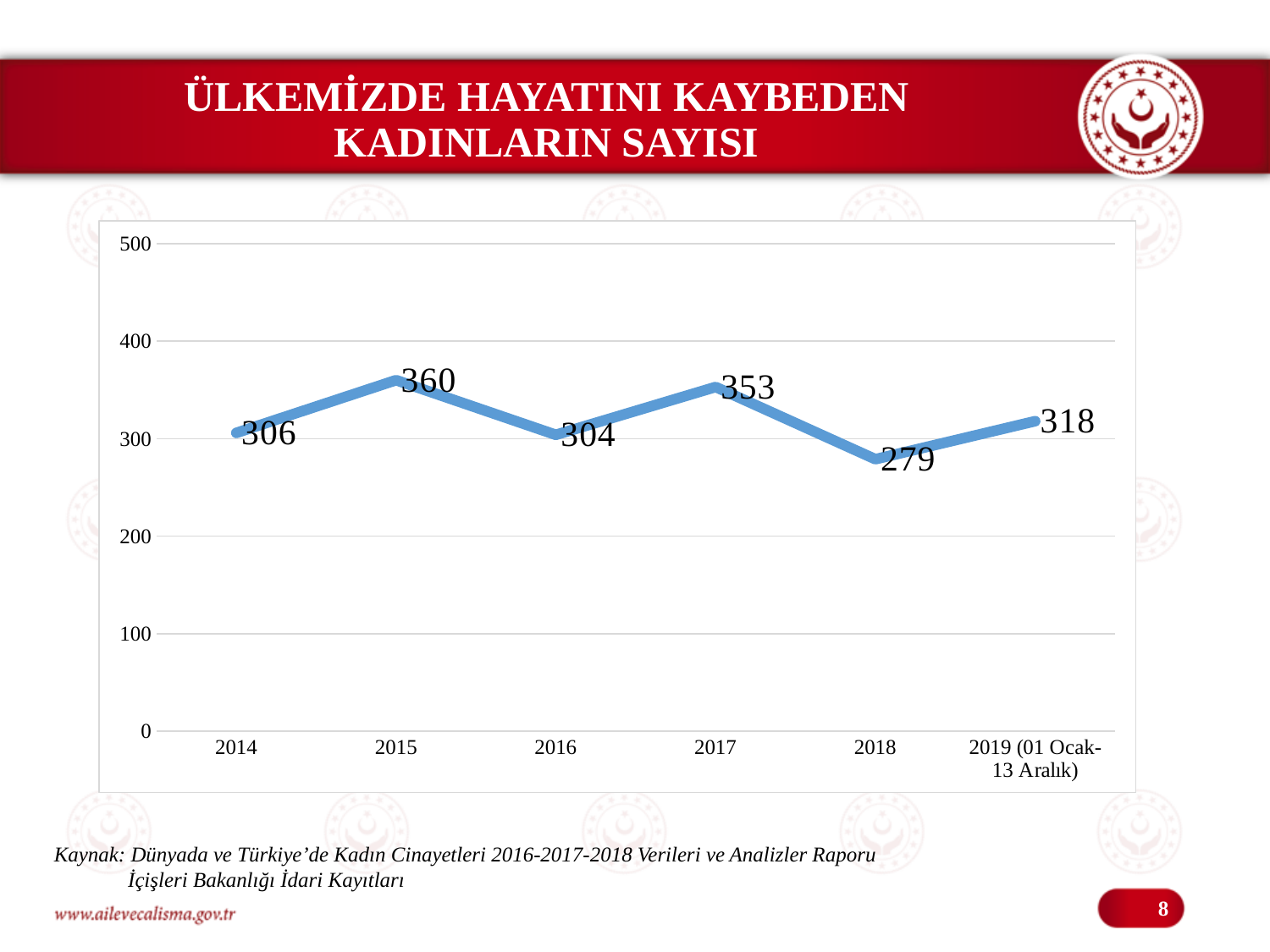
What is the value for 2015? 360 How many data points are plotted on the chart? 6 What is the difference between the values for 2017 and 2016? 49 What is the difference between the values for 2015 and 2018? 81 What kind of chart is shown on the slide? line chart What is the value for 2018? 279 Which year has the highest value? 2015 What is the value for 2014? 306 Which is larger, the value for 2014 or the value for 2016? 2014 What is the value for 2019 (01 Ocak-13 Aralık)? 318 Which year has the lowest value? 2018 Is the value for 2017 greater or less than 400? less